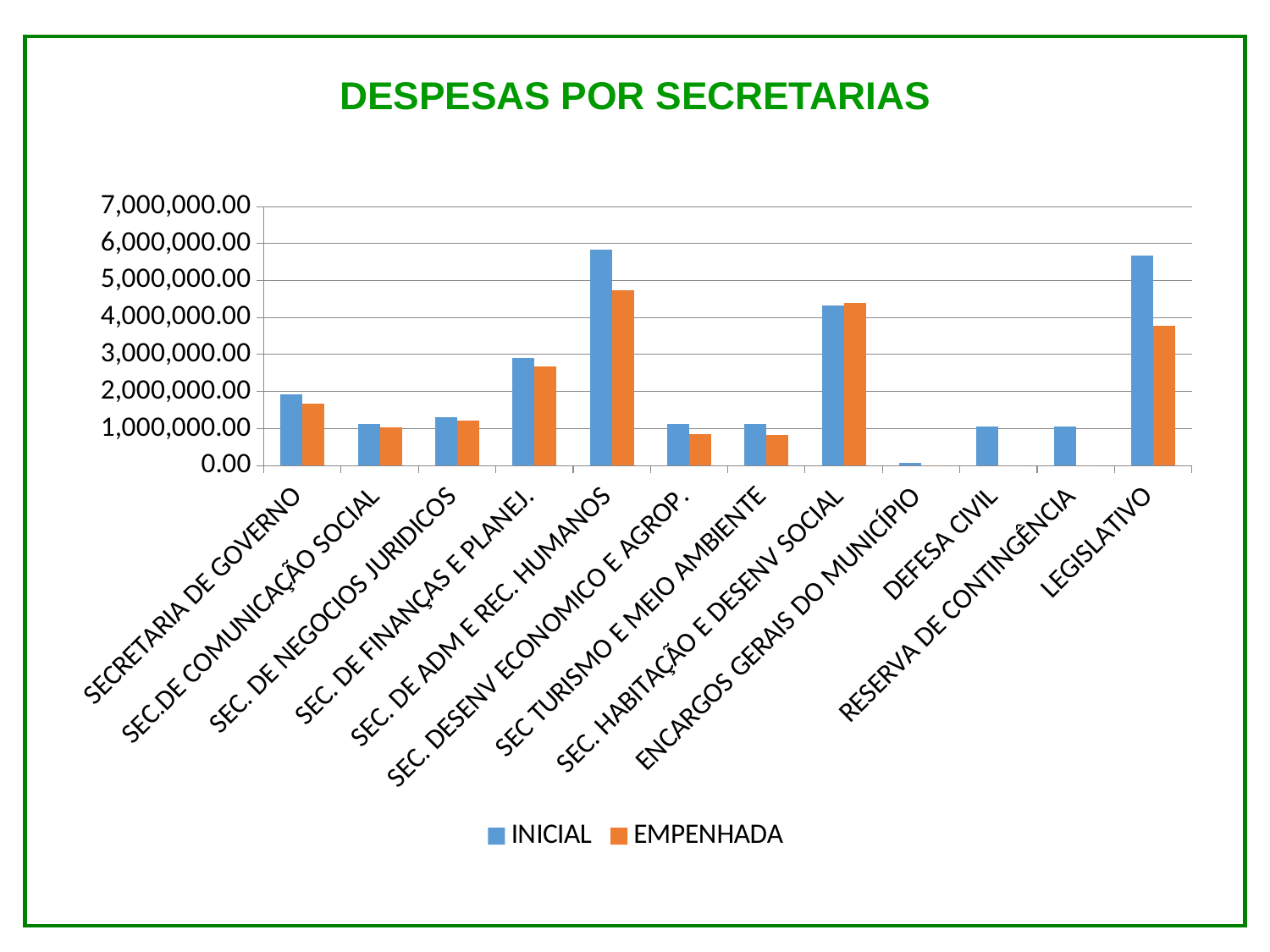
Which category has the lowest INICIAL value? ENCARGOS GERAIS DO MUNICÍPIO Which category has the highest EMPENHADA value? SEC. DE ADM E REC. HUMANOS What is the title of the chart? DESPESAS POR SECRETARIAS How many series does the legend list? 2 Is the INICIAL value for SEC. DE ADM E REC. HUMANOS greater or less than 5,000,000.00? greater What kind of chart is shown on the slide? bar chart For LEGISLATIVO, which is larger: the INICIAL value or the EMPENHADA value? INICIAL Is the EMPENHADA value for LEGISLATIVO greater or less than 4,000,000.00? less How many categories (secretarias) are shown on the x axis? 12 Which series is shown in orange in the legend? EMPENHADA Is the EMPENHADA value for SEC. DE FINANÇAS E PLANEJ. greater or less than 3,000,000.00? less